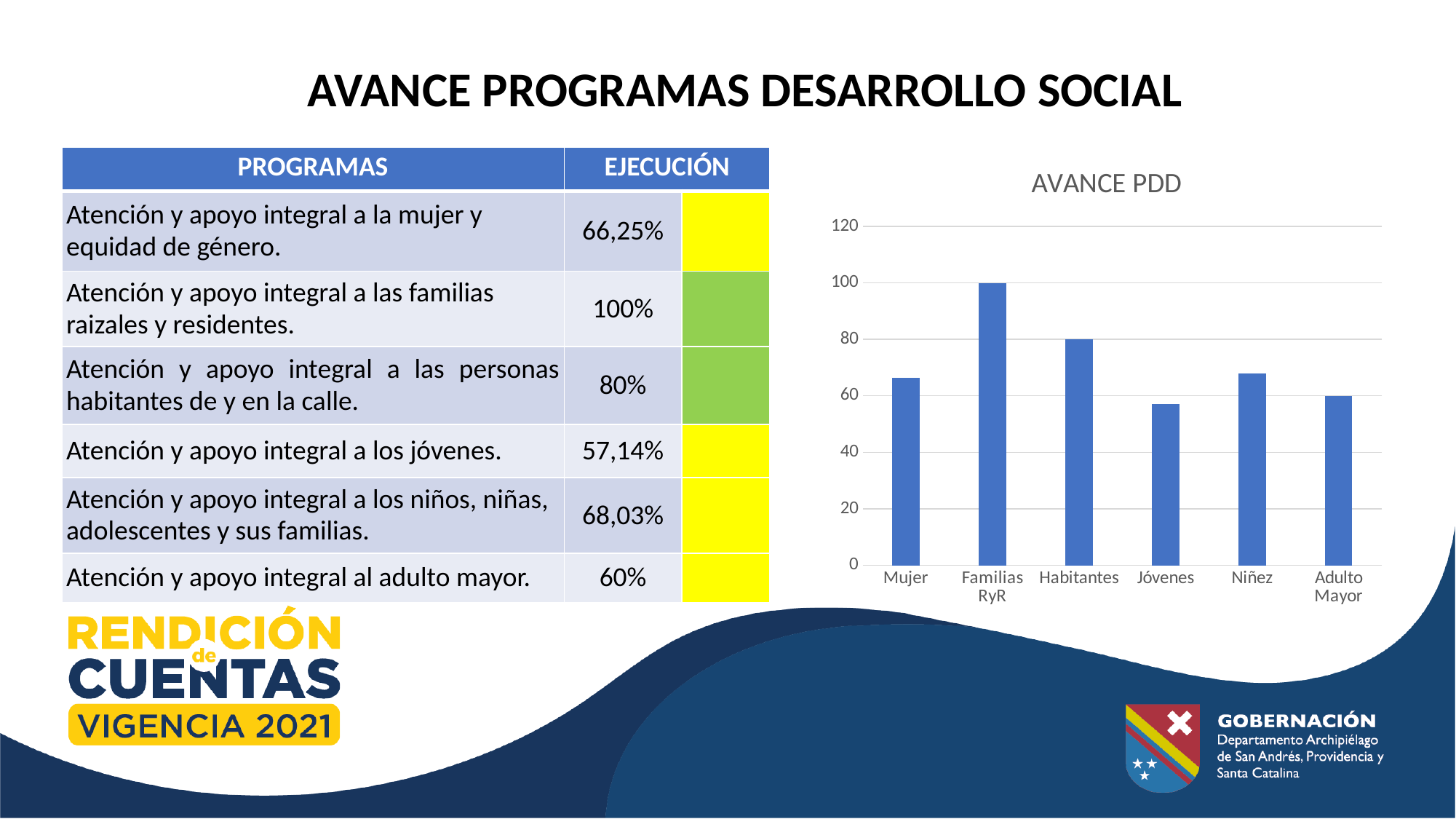
What type of chart is shown on the slide? bar chart Is the value for Niñez greater or less than 80? less Which is larger, the value for Habitantes or the value for Niñez? Habitantes How many categories are shown on the x axis of the chart? 6 Is the value for Jóvenes greater or less than 60? less Which category has the highest bar in the chart? Familias RyR What is the value for Habitantes in the chart? 80 What is the value for Adulto Mayor in the chart? 60 What is the title of the chart? AVANCE PDD Is the value for Mujer greater or less than 60? greater